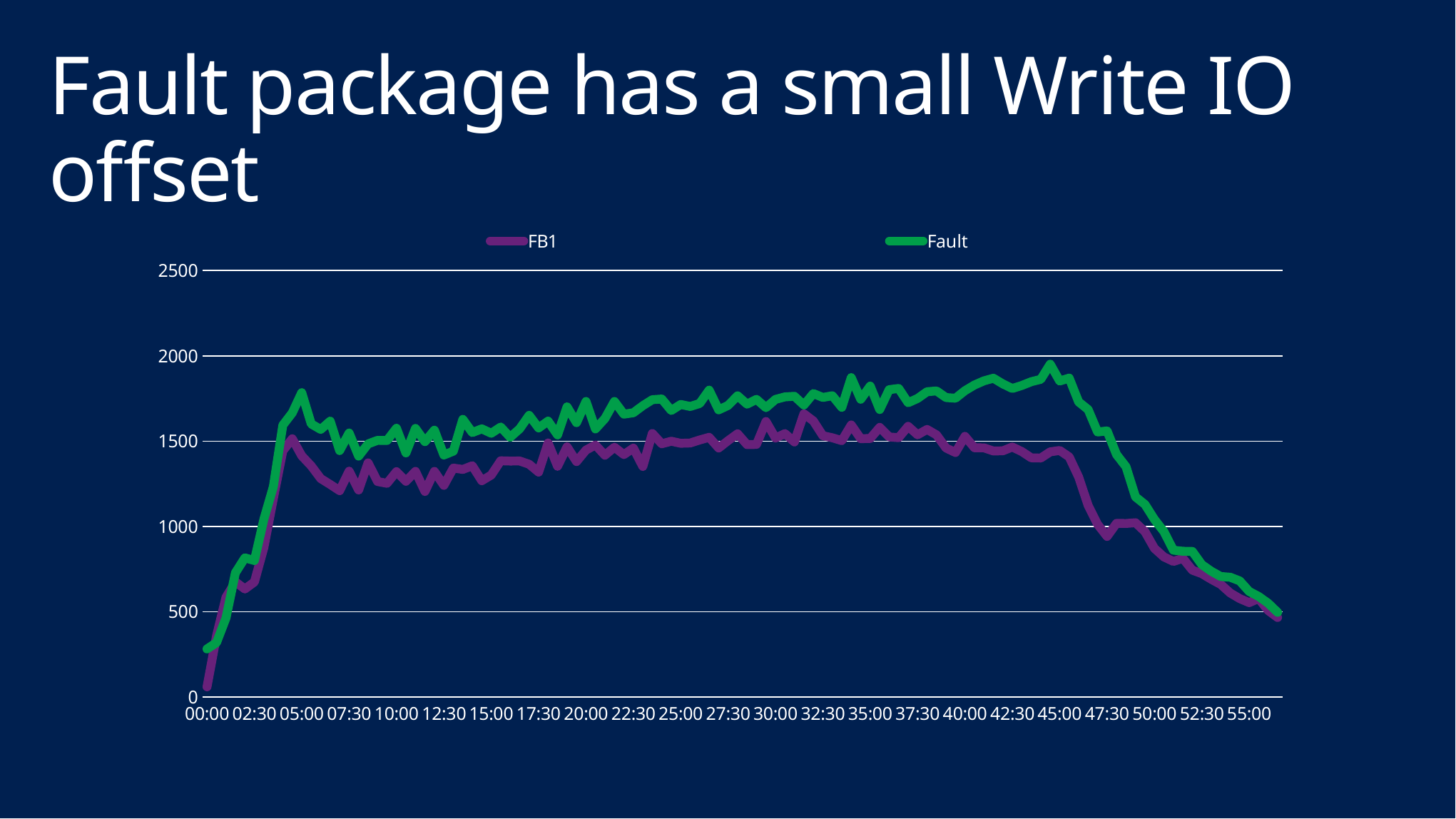
Is the value for Fault at 45:00 greater or less than 1500? greater Do the values for Fault rise or fall between 45:00 and 55:00? fall Is the value for Fault at 00:00 greater or less than 500? less How many series does the legend list? 2 What is the highest value labelled on the vertical axis? 2500 What are the names of the two series in the legend? FB1 and Fault At 10:00, which series has the larger value, FB1 or Fault? Fault Is the value for Fault at 25:00 greater or less than 1500? greater What colour is the Fault series line? green What kind of chart is shown on the slide? line chart At 45:00, which series has the larger value, FB1 or Fault? Fault